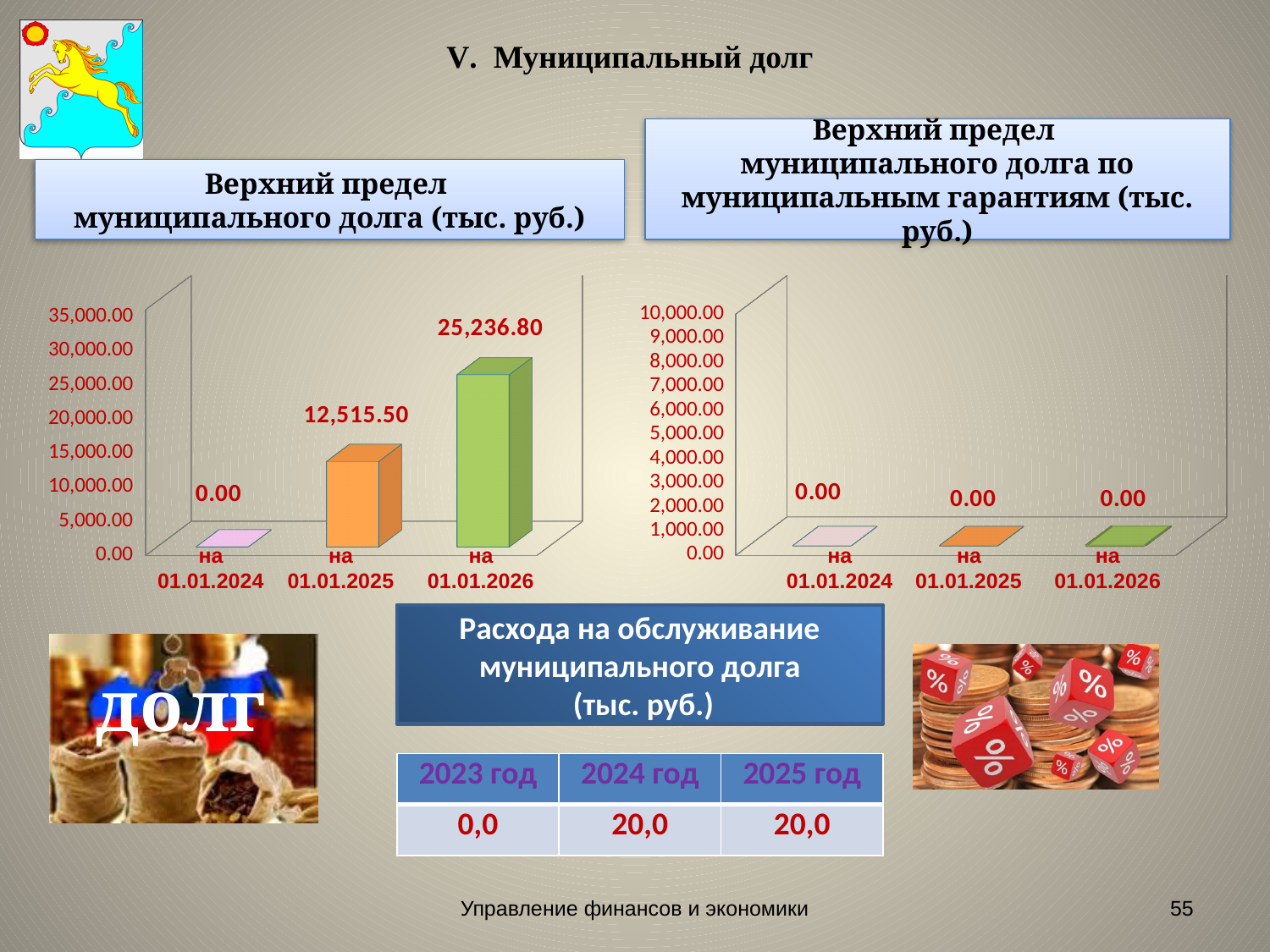
In the chart 'Верхний предел муниципального долга (тыс. руб.)', what is the difference between the values for на 01.01.2026 and на 01.01.2025? 12,721.30 In the chart 'Верхний предел муниципального долга (тыс. руб.)', which is larger: the value for на 01.01.2025 or на 01.01.2026? на 01.01.2026 In the chart 'Верхний предел муниципального долга (тыс. руб.)', what is the value for на 01.01.2024? 0.00 In the chart 'Верхний предел муниципального долга по муниципальным гарантиям (тыс. руб.)', what is the highest value shown on the vertical axis? 10,000.00 In the chart 'Верхний предел муниципального долга (тыс. руб.)', what is the value for на 01.01.2025? 12,515.50 What kind of chart is 'Верхний предел муниципального долга по муниципальным гарантиям (тыс. руб.)'? bar chart In the chart 'Верхний предел муниципального долга (тыс. руб.)', which category has the highest value? на 01.01.2026 In the chart 'Верхний предел муниципального долга (тыс. руб.)', how many categories are shown on the x axis? 3 In the chart 'Верхний предел муниципального долга (тыс. руб.)', what is the value for на 01.01.2026? 25,236.80 In the chart 'Верхний предел муниципального долга по муниципальным гарантиям (тыс. руб.)', what is the value for на 01.01.2025? 0.00 In the chart 'Верхний предел муниципального долга (тыс. руб.)', which category has the lowest value? на 01.01.2024 In the chart 'Верхний предел муниципального долга (тыс. руб.)', do the values rise or fall from на 01.01.2024 to на 01.01.2026? rise